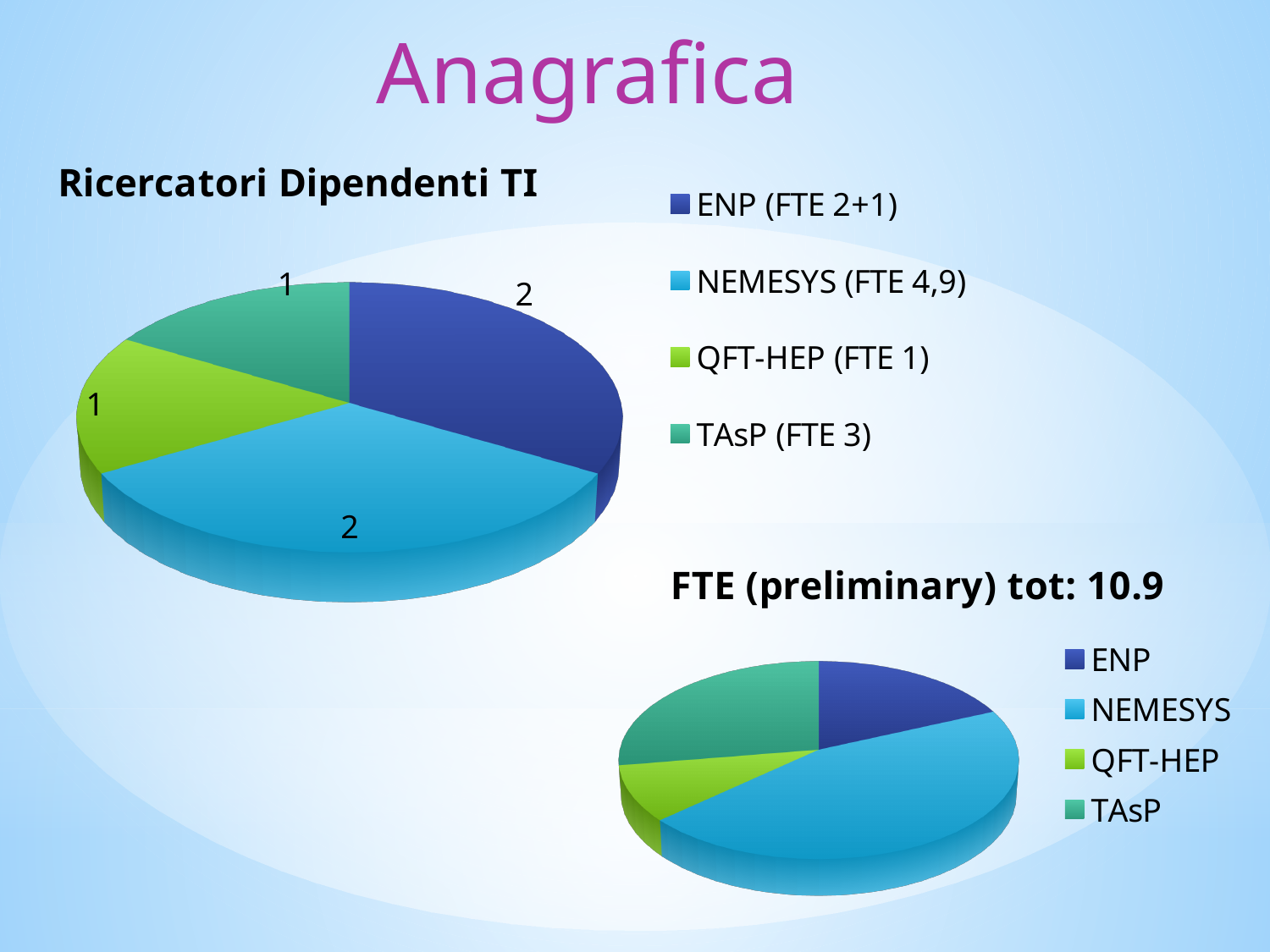
In the 'Ricercatori Dipendenti TI' pie chart, what is the difference between the values for ENP and QFT-HEP? 1 In the 'Ricercatori Dipendenti TI' pie chart, what is the value for TAsP? 1 In the 'FTE (preliminary) tot: 10.9' pie chart, which category has the smallest slice? QFT-HEP In the 'Ricercatori Dipendenti TI' pie chart, what is the value for ENP? 2 What kind of chart is the 'FTE (preliminary) tot: 10.9' chart? Pie chart In the 'Ricercatori Dipendenti TI' pie chart, which is larger, the value for NEMESYS or the value for TAsP? NEMESYS In the 'Ricercatori Dipendenti TI' pie chart, what is the value for QFT-HEP? 1 In the 'Ricercatori Dipendenti TI' pie chart, what is the sum of all the slice values? 6 How many categories does the 'Ricercatori Dipendenti TI' pie chart show? 4 In the 'FTE (preliminary) tot: 10.9' pie chart, which category has the largest slice? NEMESYS In the 'Ricercatori Dipendenti TI' pie chart, what is the value for NEMESYS? 2 In the 'Ricercatori Dipendenti TI' chart legend, what FTE value is given next to NEMESYS? FTE 4,9